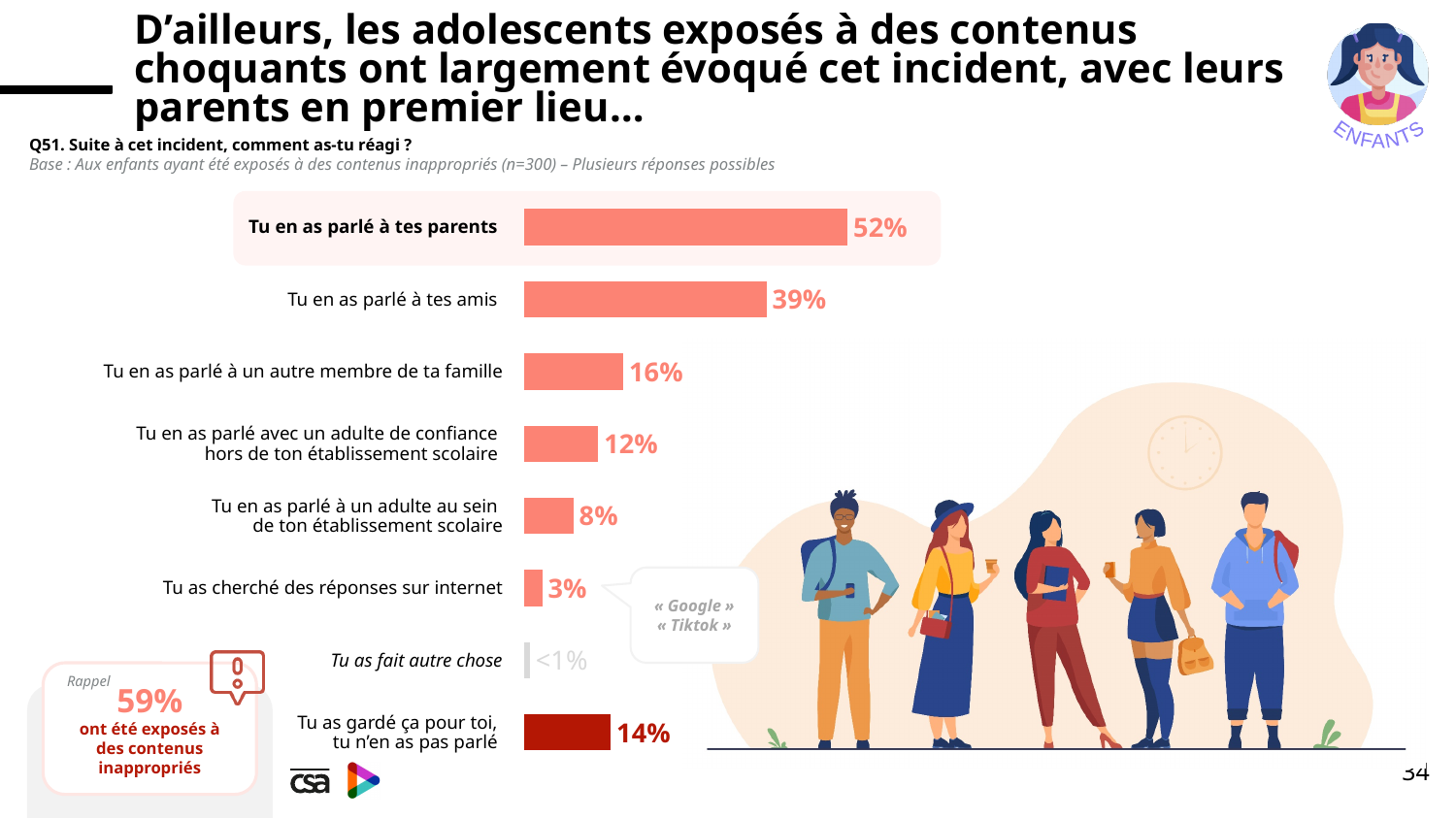
What is the value shown for "Tu en as parlé à tes amis"? 39% What is the value shown for "Tu en as parlé à un adulte au sein de ton établissement scolaire"? 8% What is the difference in percentage points between "Tu en as parlé à tes parents" and "Tu en as parlé à tes amis"? 13 percentage points What value is shown for "Tu as cherché des réponses sur internet"? 3% What percentage of respondents said "Tu en as parlé à tes parents"? 52% How many response categories are shown in the chart? 8 Which response has the lowest percentage in the chart? Tu as fait autre chose Which is larger: the value for "Tu en as parlé à un autre membre de ta famille" or for "Tu as gardé ça pour toi, tu n'en as pas parlé"? Tu en as parlé à un autre membre de ta famille What percentage is shown for "Tu as gardé ça pour toi, tu n'en as pas parlé"? 14% Which two examples are given in the callout next to "Tu as cherché des réponses sur internet"? « Google » and « Tiktok » What type of chart is shown on the slide? Bar chart Which response has the highest percentage in the chart? Tu en as parlé à tes parents